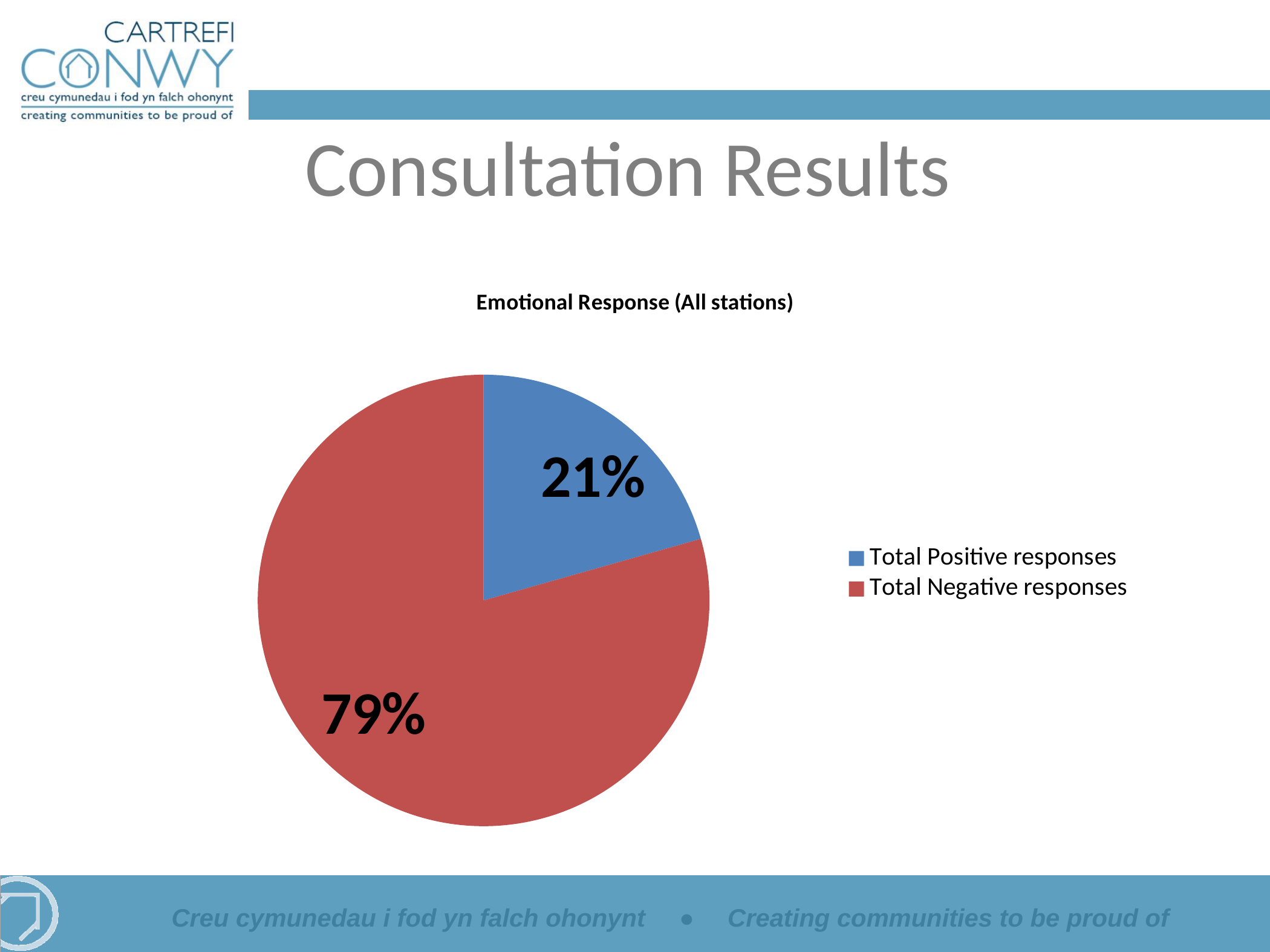
What share of the pie is Total Negative responses? 79% Which category has the smallest slice of the pie? Total Positive responses What colour is the slice for Total Negative responses? Red What is the difference in percentage points between Total Negative responses and Total Positive responses? 58 What is the title of the chart? Emotional Response (All stations) Which is larger, Total Positive responses or Total Negative responses? Total Negative responses Which category has the largest slice of the pie? Total Negative responses What share of the pie is Total Positive responses? 21% What type of chart is shown on the slide? Pie chart How many entries does the legend list? 2 How many slices does the pie chart have? 2